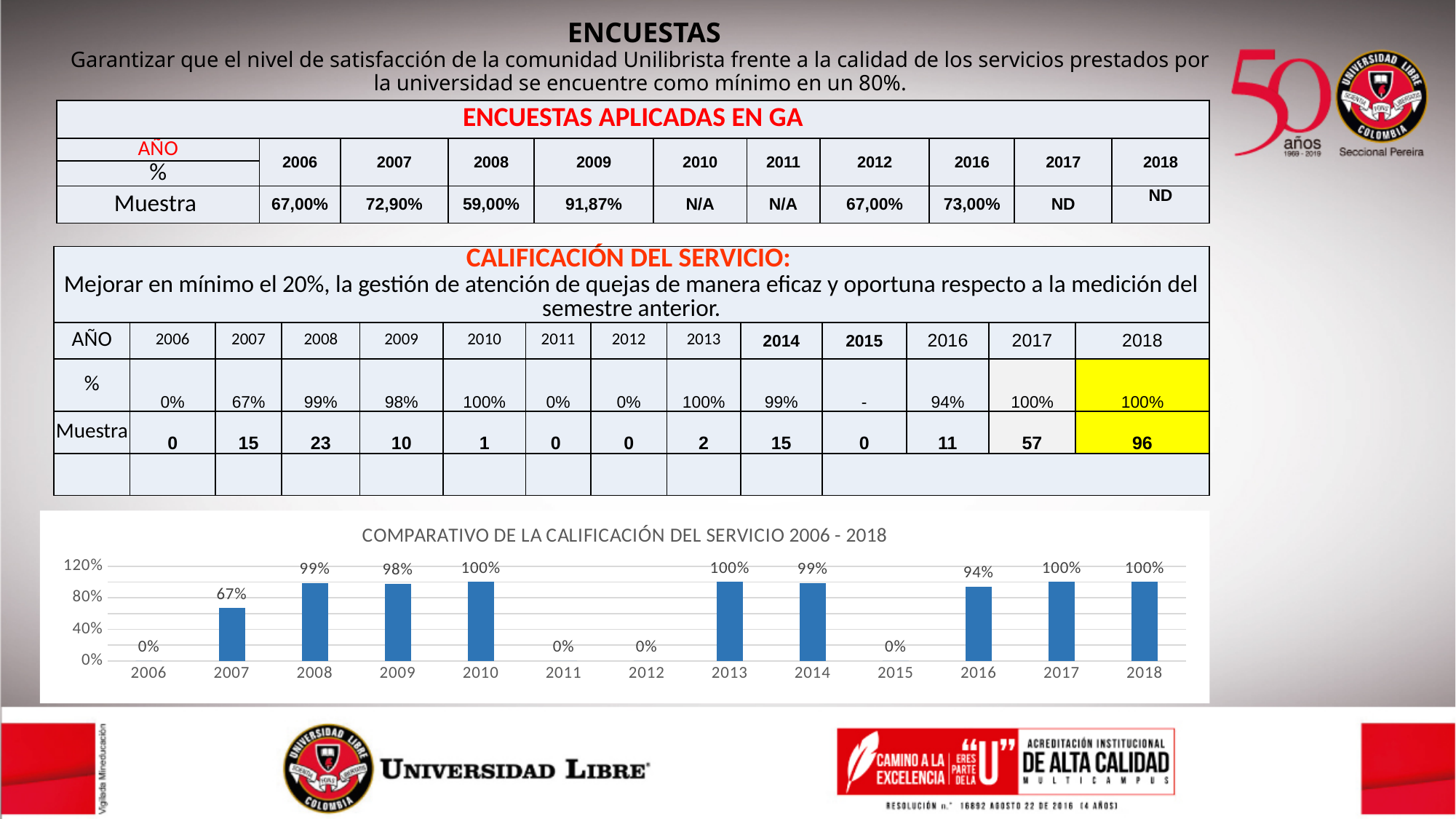
How many years in the chart have a value of 0%? 4 What is the value for 2014 in the chart? 99% Which is larger in the chart, the value for 2016 or the value for 2017? 2017 Is the value for 2007 in the chart greater or less than 80%? less What is the value for 2007 in the chart 'COMPARATIVO DE LA CALIFICACIÓN DEL SERVICIO 2006 - 2018'? 67% What kind of chart is shown on the slide? bar chart What is the difference between the values for 2008 and 2007 in the chart? 32% How many years are shown on the x axis of the chart? 13 What is the value for 2016 in the chart? 94% Which year has the lowest value among 2007, 2008 and 2009 in the chart? 2007 What is the title of the chart on the slide? COMPARATIVO DE LA CALIFICACIÓN DEL SERVICIO 2006 - 2018 What is the value for 2009 in the chart? 98%